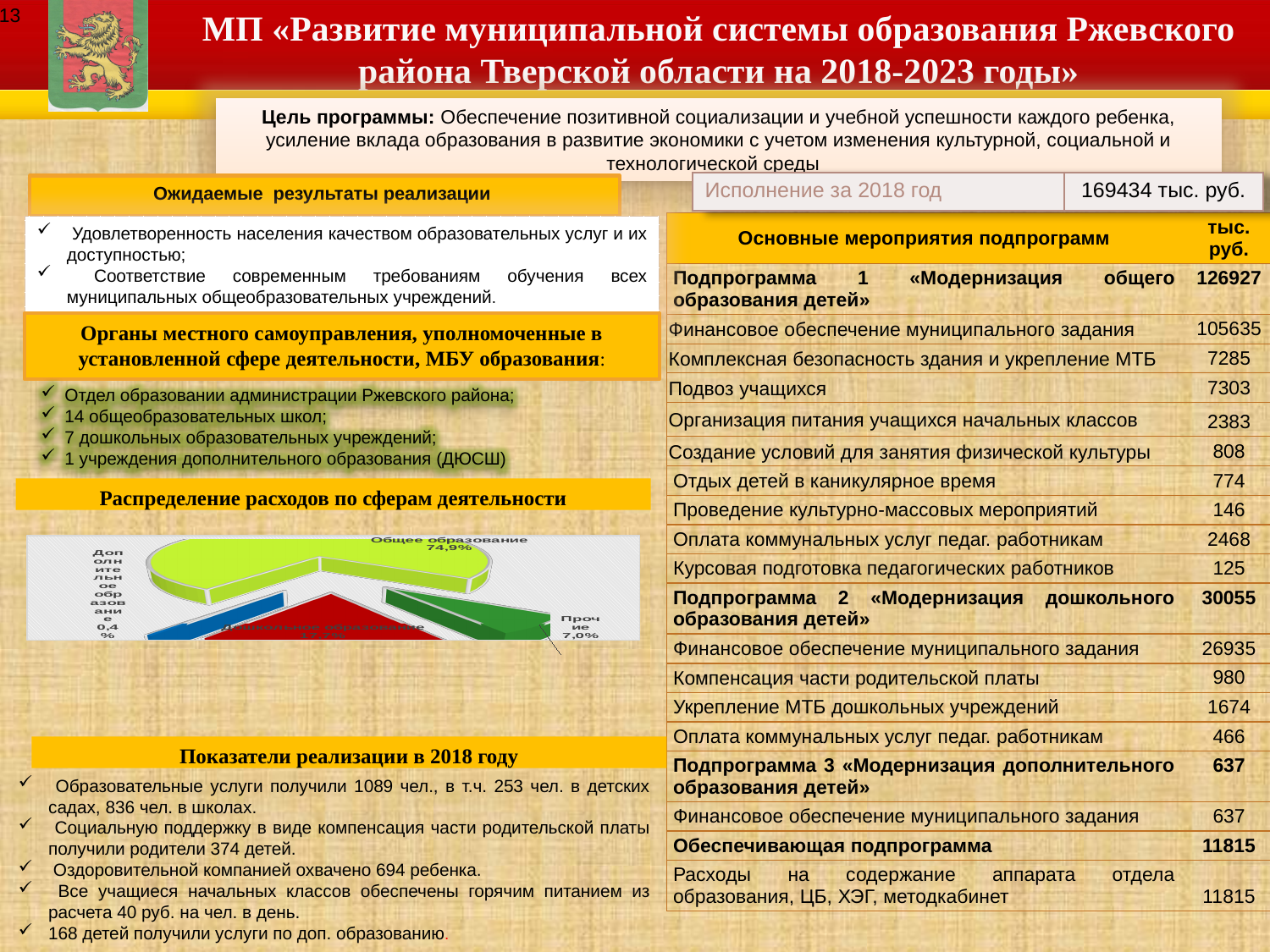
In the pie chart «Распределение расходов по сферам деятельности», which is larger: the share for «Прочие» or for «Дополнительное образование»? Прочие What is the title shown above the pie chart on the slide? Распределение расходов по сферам деятельности In the pie chart «Распределение расходов по сферам деятельности», what share is labelled for «Общее образование»? 74,9% In the pie chart «Распределение расходов по сферам деятельности», by how many percentage points does the share for «Общее образование» exceed the share for «Прочие»? 67,9% In the pie chart «Распределение расходов по сферам деятельности», what share is labelled for «Дополнительное образование»? 0,4% In the pie chart «Распределение расходов по сферам деятельности», which category has the largest share? Общее образование In the pie chart «Распределение расходов по сферам деятельности», which is larger: the share for «Общее образование» or for «Дошкольное образование»? Общее образование In the pie chart «Распределение расходов по сферам деятельности», which category has the smallest share? Дополнительное образование What kind of chart is shown under the heading «Распределение расходов по сферам деятельности»? pie chart In the pie chart «Распределение расходов по сферам деятельности», what share is labelled for «Прочие»? 7,0% How many slices does the pie chart «Распределение расходов по сферам деятельности» have? 4 In the pie chart «Распределение расходов по сферам деятельности», by how many percentage points does the share for «Прочие» exceed the share for «Дополнительное образование»? 6,6%